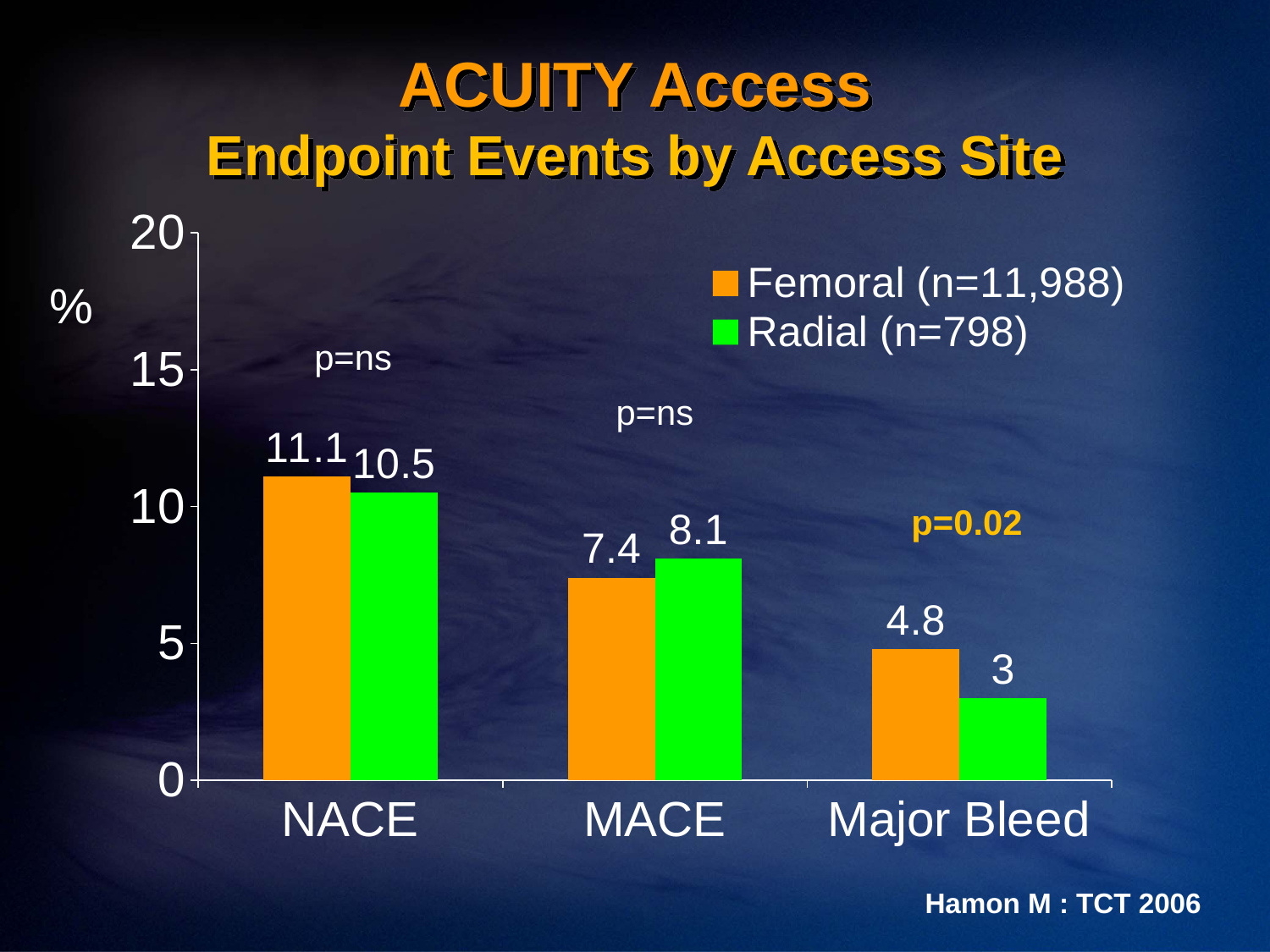
What kind of chart is shown on the slide? bar chart How many categories are shown on the x axis? 3 For MACE, which is larger, the Femoral or the Radial value? Radial What is the Femoral value for Major Bleed? 4.8 Is the Femoral value for NACE greater or less than 10? greater Which category has the lowest Radial value? Major Bleed What is the Radial value for Major Bleed? 3 How many series does the legend list? 2 What is the Femoral value for NACE? 11.1 What is the Radial value for MACE? 8.1 What is the difference between the Femoral and Radial values for Major Bleed? 1.8 Which category has the highest Femoral value? NACE